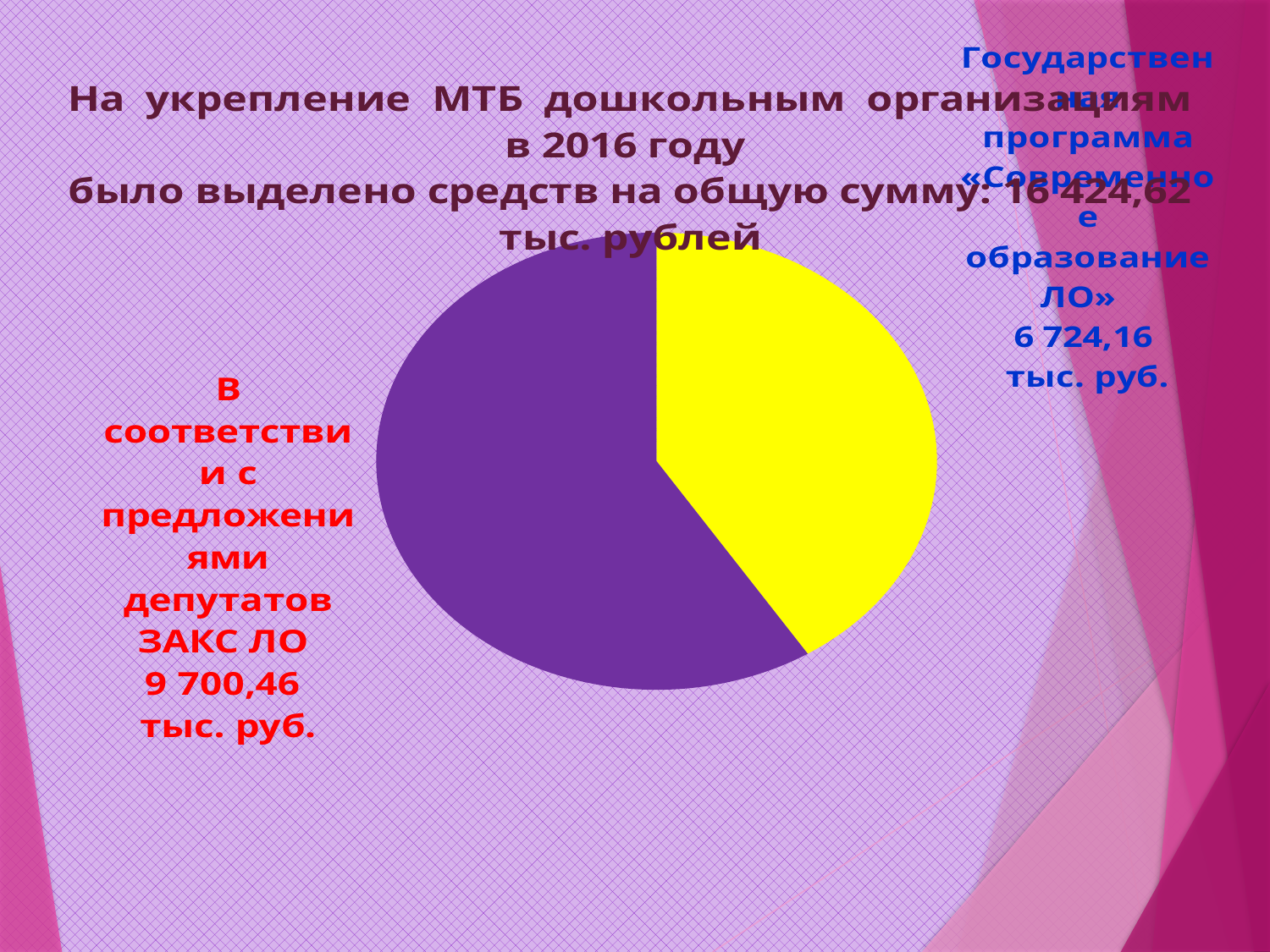
Which is larger: the funds from the deputies of ЗАКС ЛО or the funds from the state programme «Современное образование ЛО»? deputies of ЗАКС ЛО What amount was allocated in accordance with the proposals of the deputies of ЗАКС ЛО? 9 700,46 тыс. руб. How many slices does the pie chart have? 2 Which source of funds accounts for the larger slice of the pie? предложения депутатов ЗАКС ЛО What is the difference between the ЗАКС ЛО funds (9 700,46) and the state programme funds (6 724,16), in тыс. руб.? 2 976,30 Which source of funds accounts for the smaller slice of the pie? Государственная программа «Современное образование ЛО» What amount was allocated under the state programme «Современное образование ЛО»? 6 724,16 тыс. руб. What colour is the slice representing the state programme «Современное образование ЛО»? yellow What kind of chart is shown on the slide? pie chart What colour is the larger slice of the pie chart? purple What is the total amount of funds allocated in 2016 according to the slide? 16 424,62 тыс. рублей